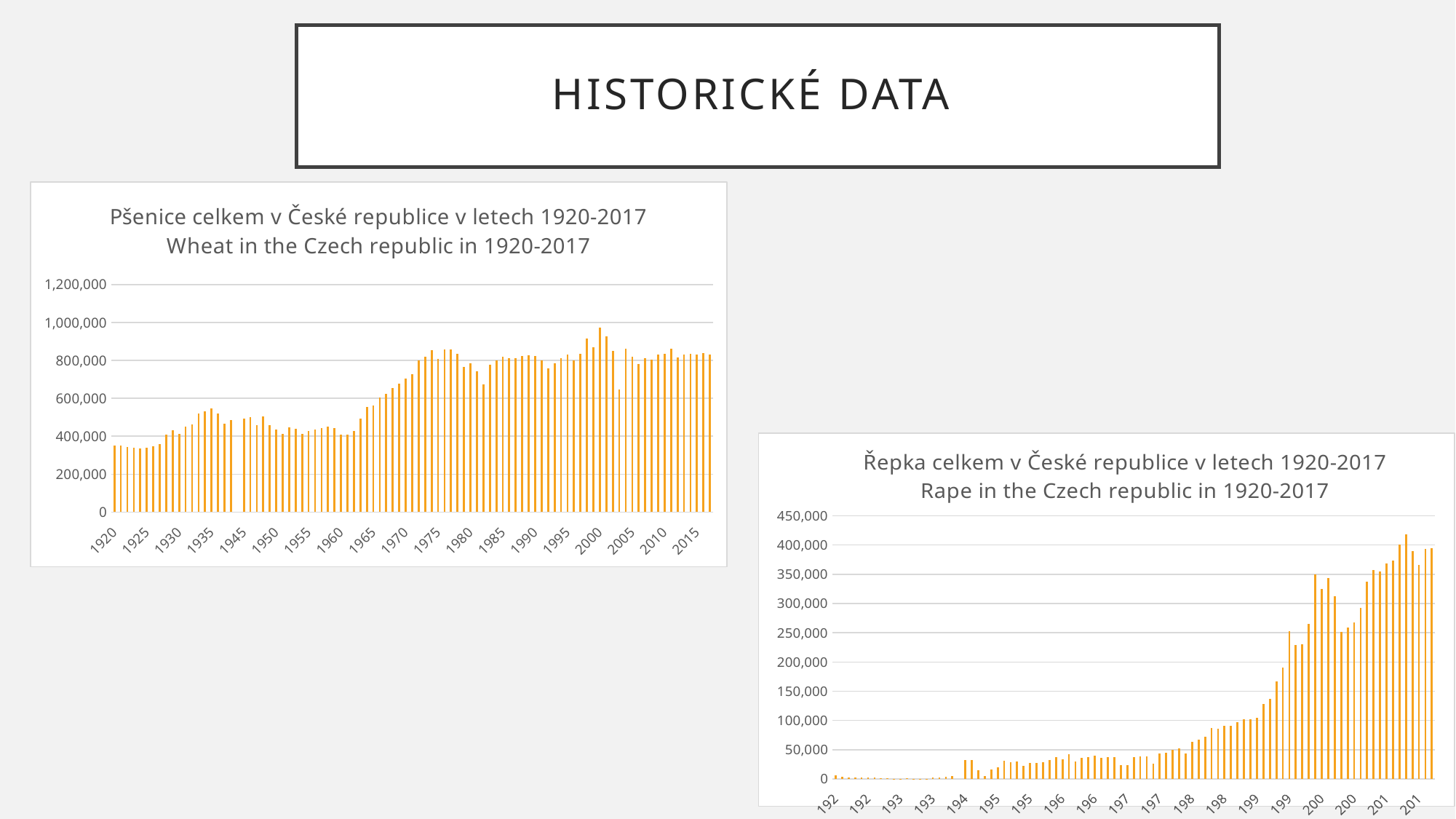
In the 'Rape in the Czech republic in 1920-2017' chart, is the value for 1970 greater or less than 50,000? less In the 'Rape in the Czech republic in 1920-2017' chart, is the highest bar greater or less than 400,000? greater In the 'Wheat in the Czech republic in 1920-2017' chart, is the value for 1920 greater or less than 400,000? less How many charts are shown on the slide? 2 In the 'Wheat in the Czech republic in 1920-2017' chart, do the values generally rise or fall from 1920 to 2017? rise What is the English title of the chart in the lower right of the slide? Rape in the Czech republic in 1920-2017 What kind of chart is the 'Rape in the Czech republic in 1920-2017' chart? bar chart In the 'Rape in the Czech republic in 1920-2017' chart, do the values generally rise or fall from 1920 to 2017? rise What kind of chart is the 'Wheat in the Czech republic in 1920-2017' chart? bar chart